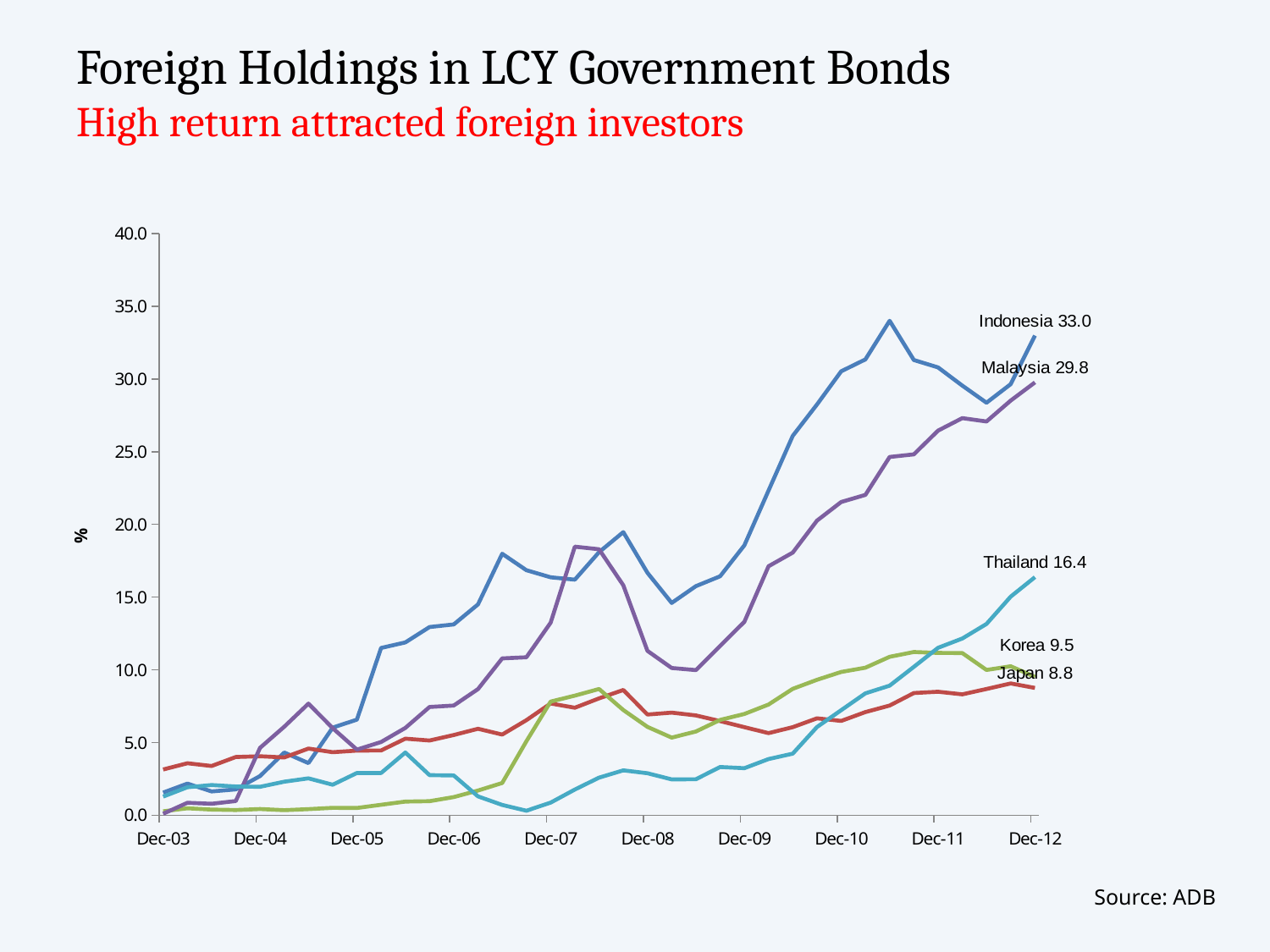
Which country has the lowest foreign holdings share at Dec-12? Japan What is the value labelled for Japan at the end of the series (Dec-12)? 8.8 At Dec-12, which is larger: the value for Korea or the value for Japan? Korea Which country has the highest foreign holdings share at Dec-12? Indonesia Is the value for Malaysia at Dec-08 greater or less than 15.0? less What is the value labelled for Indonesia at the end of the series (Dec-12)? 33.0 What type of chart is shown on the slide? Line chart What is the difference between the Dec-12 values for Thailand and Korea? 6.9 What is the difference between the Dec-12 values for Indonesia and Malaysia? 3.2 How many country series are plotted on the chart? 5 What is the value labelled for Thailand at the end of the series (Dec-12)? 16.4 What is the value labelled for Malaysia at the end of the series (Dec-12)? 29.8